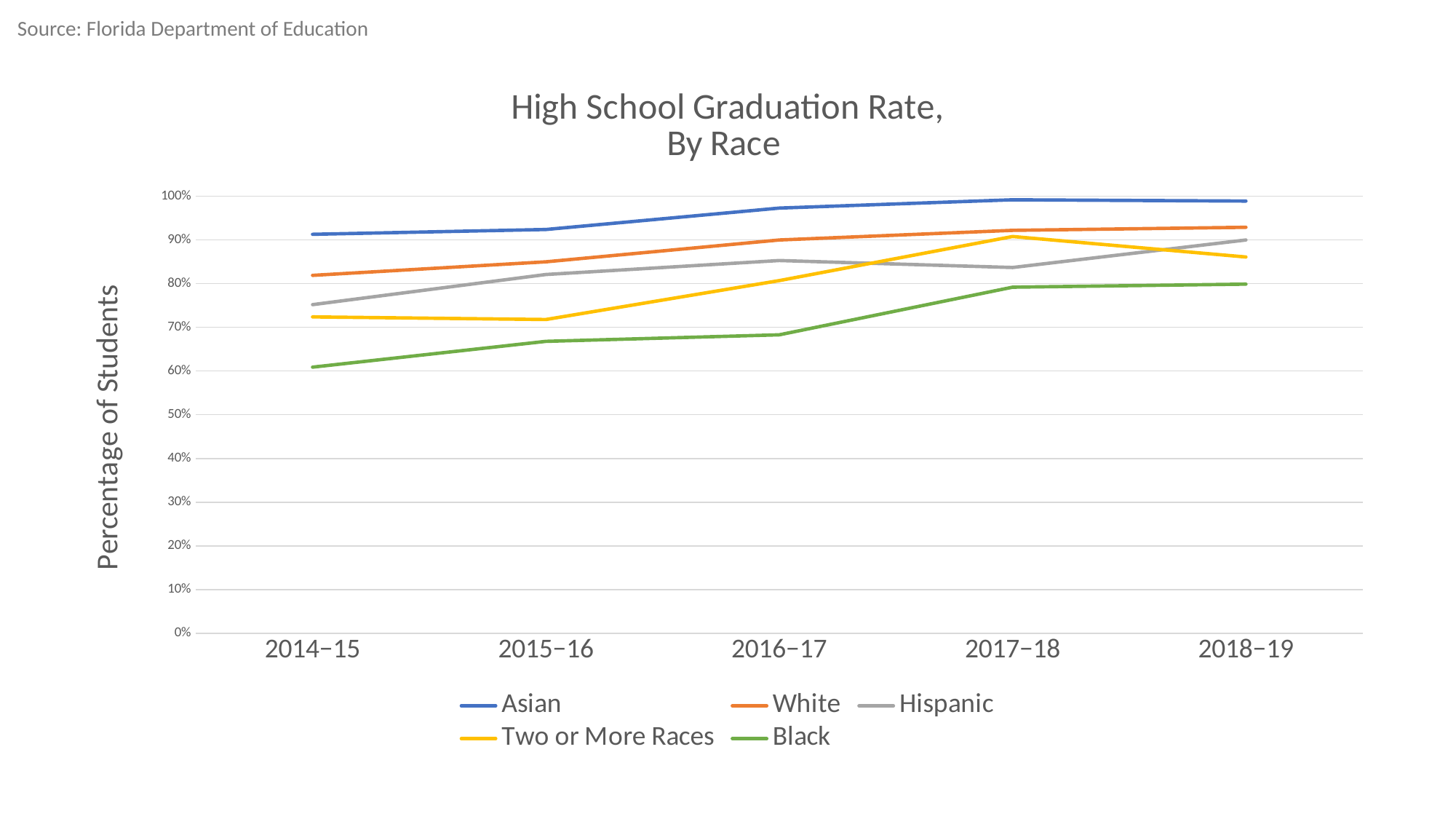
Is the value for Hispanic in 2014–15 greater or less than 80%? less Which race had the lowest graduation rate in 2014–15? Black In 2017–18, which is larger: the value for Two or More Races or the value for Hispanic? Two or More Races What kind of chart is shown on the slide? line chart In 2016–17, which is larger: the value for Hispanic or the value for Black? Hispanic What is the label on the y axis? Percentage of Students Which race had the highest graduation rate in 2014–15? Asian Does the Black graduation rate rise or fall from 2014–15 to 2018–19? rise How many series does the legend list? 5 How many school years are shown on the x axis? 5 Is the value for Black in 2014–15 greater or less than 70%? less Is the value for Asian in 2016–17 greater or less than 90%? greater